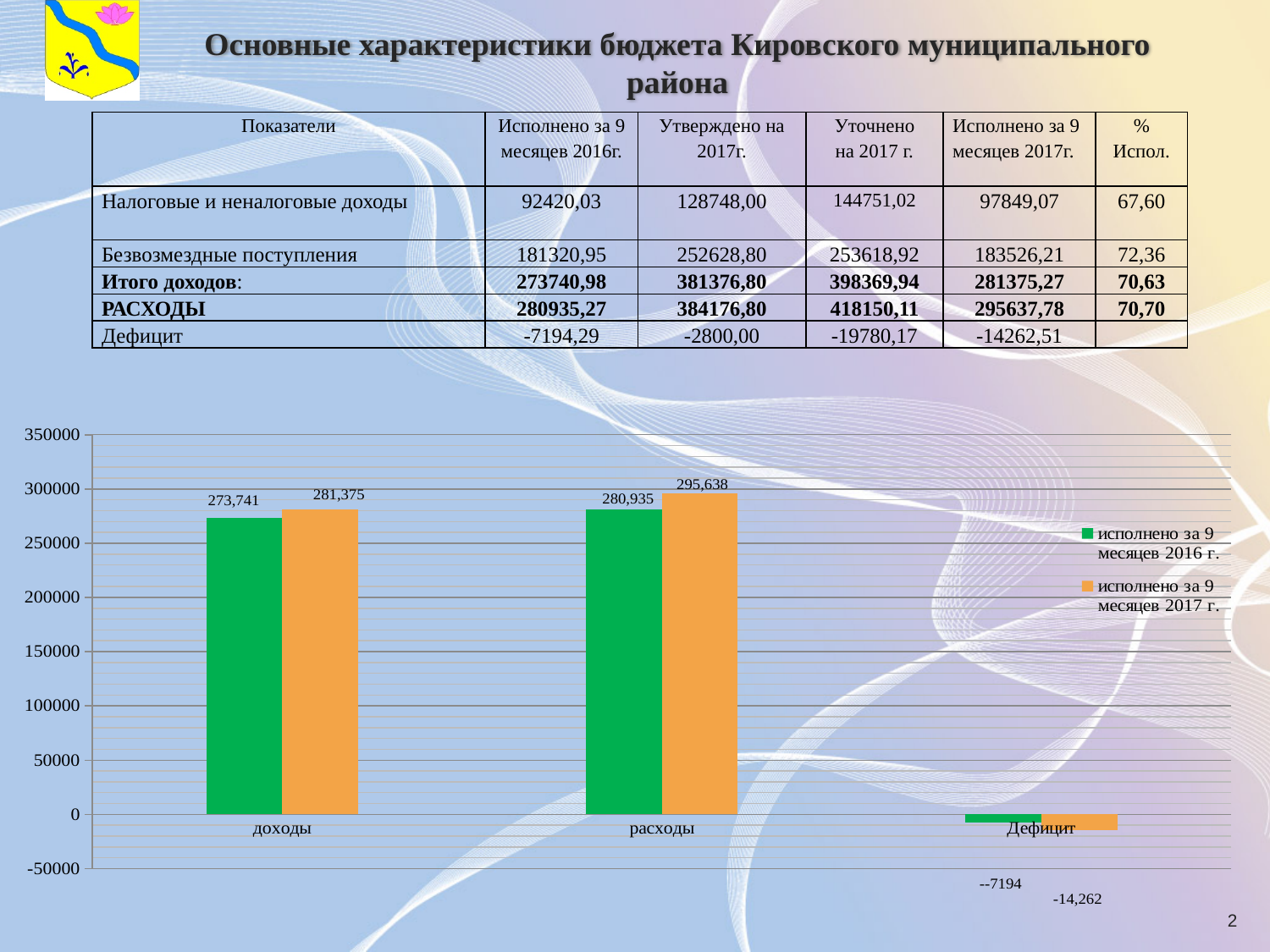
What kind of chart is shown on the slide? bar chart What is the difference between расходы and доходы in the series исполнено за 9 месяцев 2017 г.? 14,263 What is the value for Дефицит in the series исполнено за 9 месяцев 2017 г.? -14,262 What is the value for расходы in the series исполнено за 9 месяцев 2017 г.? 295,638 How many categories are shown on the x axis of the chart? 3 In the series исполнено за 9 месяцев 2017 г., which is larger: доходы or расходы? расходы What colour are the bars for the series исполнено за 9 месяцев 2017 г.? orange How many series does the chart legend list? 2 Which bar in the chart has the highest value? расходы, исполнено за 9 месяцев 2017 г. What is the value for расходы in the series исполнено за 9 месяцев 2016 г.? 280,935 What is the value for доходы in the series исполнено за 9 месяцев 2016 г.? 273,741 What is the value for доходы in the series исполнено за 9 месяцев 2017 г.? 281,375